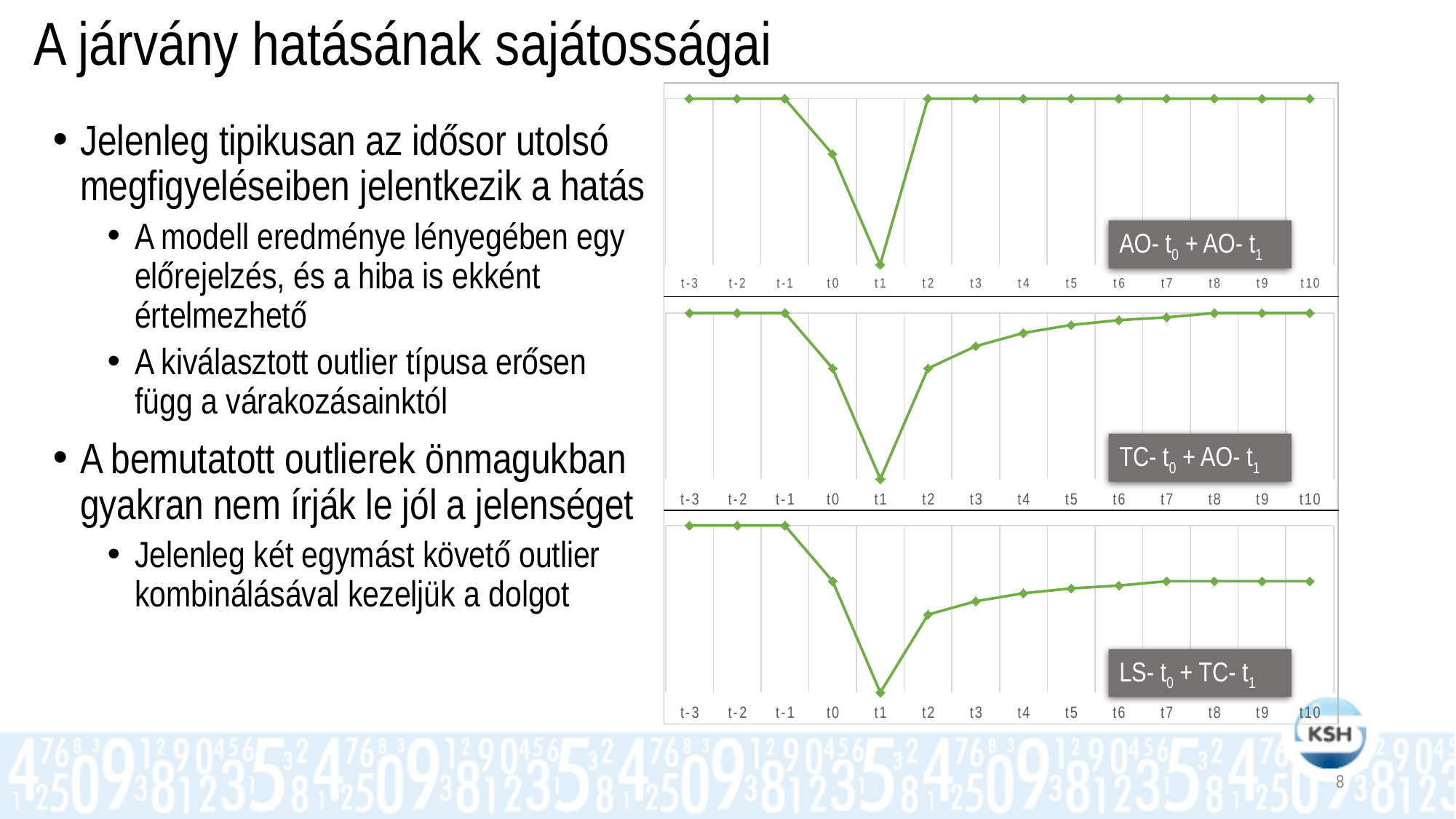
In the bottom chart (LS- t0 + TC- t1), at which time point does the line reach its minimum? t1 In the top chart (AO- t0 + AO- t1), is the value at t2 higher or lower than the value at t1? higher What kind of chart is the top chart on the slide (labelled AO- t0 + AO- t1)? line chart In the top chart (AO- t0 + AO- t1), at which time point does the line reach its lowest value? t1 In the bottom chart (LS- t0 + TC- t1), is the value at t10 higher or lower than the value at t-3? lower How many charts are shown on the slide? 3 How many time points are shown on the x axis of the top chart (AO- t0 + AO- t1)? 14 In the middle chart (TC- t0 + AO- t1), do the values rise or fall from t1 to t10? rise What colour is the line in the three charts? green In the middle chart (TC- t0 + AO- t1), at which time point is the line at its lowest? t1 In the bottom chart (LS- t0 + TC- t1), do the values rise or fall from t-1 to t1? fall What is the label shown in the grey box on the middle chart? TC- t0 + AO- t1